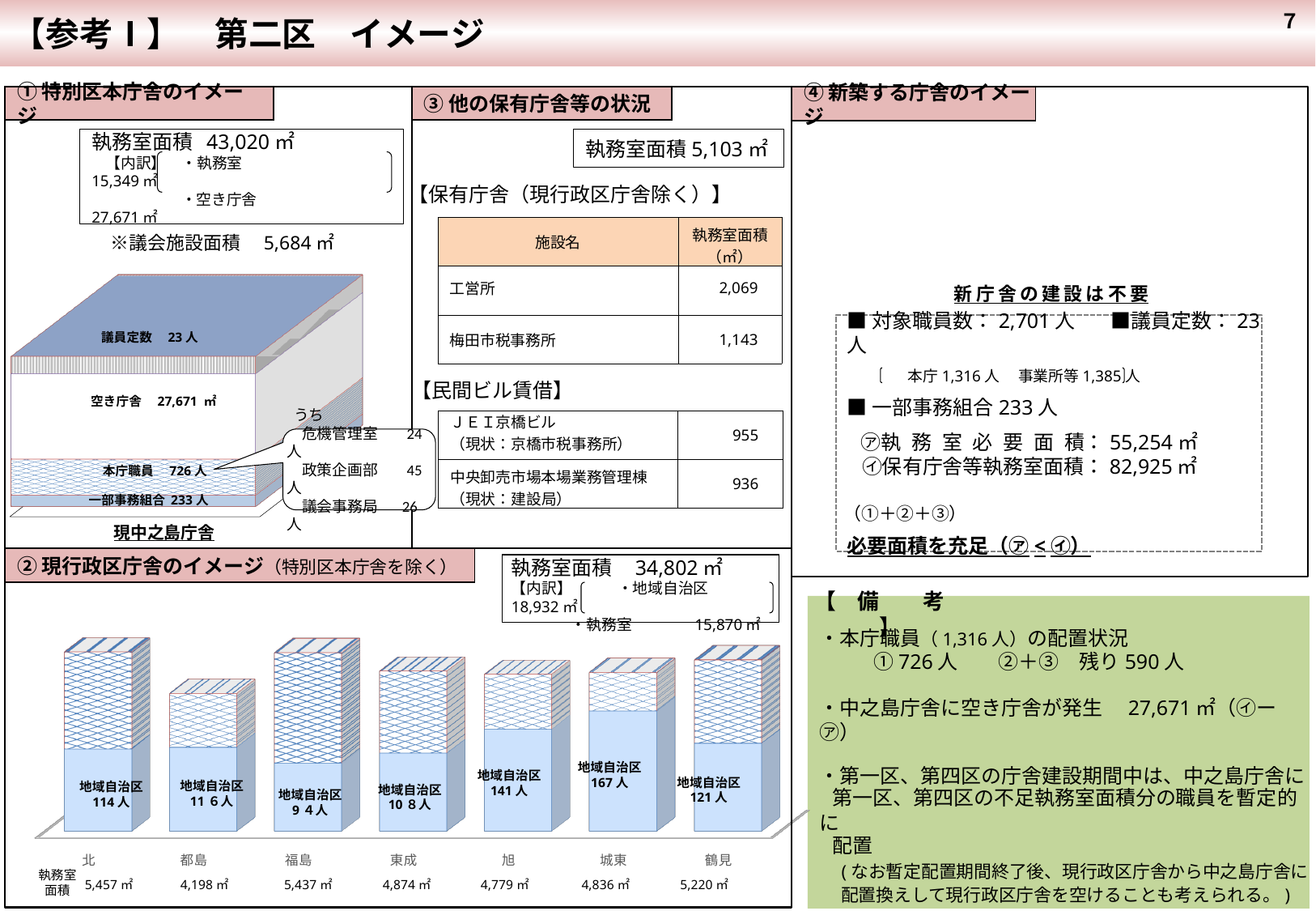
What kind of chart is shown in section ② 現行政区庁舎のイメージ? bar chart In the ② 現行政区庁舎のイメージ chart, which ward has the smallest 執務室面積? 都島 How many wards are shown in the ② 現行政区庁舎のイメージ chart? 7 In the ② 現行政区庁舎のイメージ chart, which ward has the largest 執務室面積? 北 In the ② 現行政区庁舎のイメージ chart, which ward has the highest number of 地域自治区 staff? 城東 In the ② 現行政区庁舎のイメージ chart, which has more 地域自治区 staff, 旭 or 鶴見? 旭 In the ② 現行政区庁舎のイメージ chart, how many 地域自治区 staff are shown for 城東? 167 人 In the ② 現行政区庁舎のイメージ chart, what is the difference in 執務室面積 between 北 and 都島? 1,259 ㎡ In the ② 現行政区庁舎のイメージ chart, what is the difference in 地域自治区 staff between 城東 and 福島? 73 人 In the ② 現行政区庁舎のイメージ chart, how many 地域自治区 staff are shown for 東成? 108 人 In the ② 現行政区庁舎のイメージ chart, what is the 執務室面積 for 北? 5,457 ㎡ In the ② 現行政区庁舎のイメージ chart, which ward has the lowest number of 地域自治区 staff? 福島